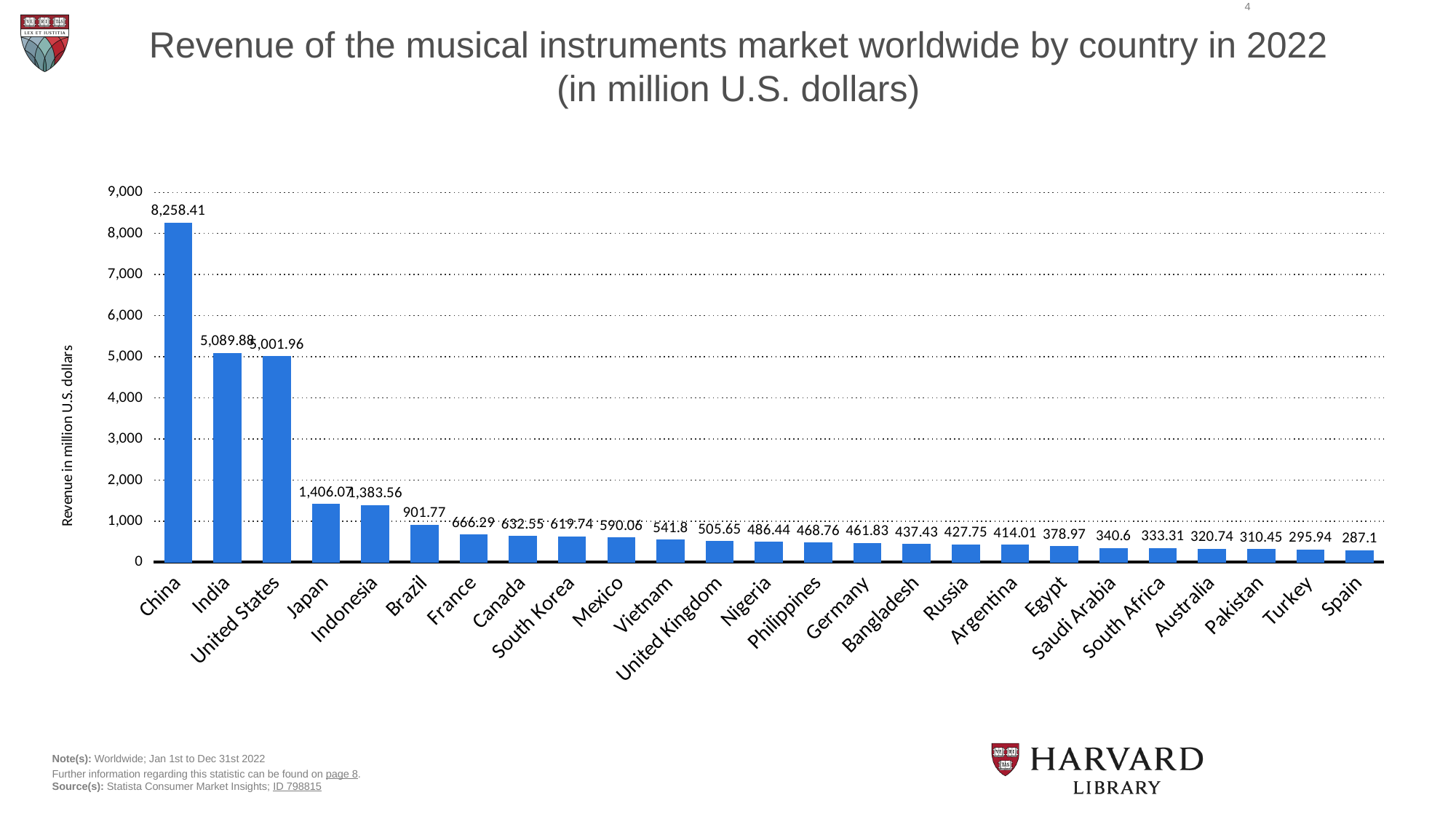
What is the revenue for Brazil? 901.77 Which country has the highest revenue? China Which has a higher revenue, Brazil or France? Brazil What is the difference in revenue between China and India? 3,168.53 How many countries are shown in the chart? 25 Do the values rise or fall from left to right along the x axis? Fall Is the value for Japan greater or less than 1,000? greater What is the revenue for China? 8,258.41 What is the revenue for Spain? 287.1 What kind of chart is shown on the slide? Bar chart What is the difference in revenue between Japan and Indonesia? 22.51 Which country has the lowest revenue? Spain